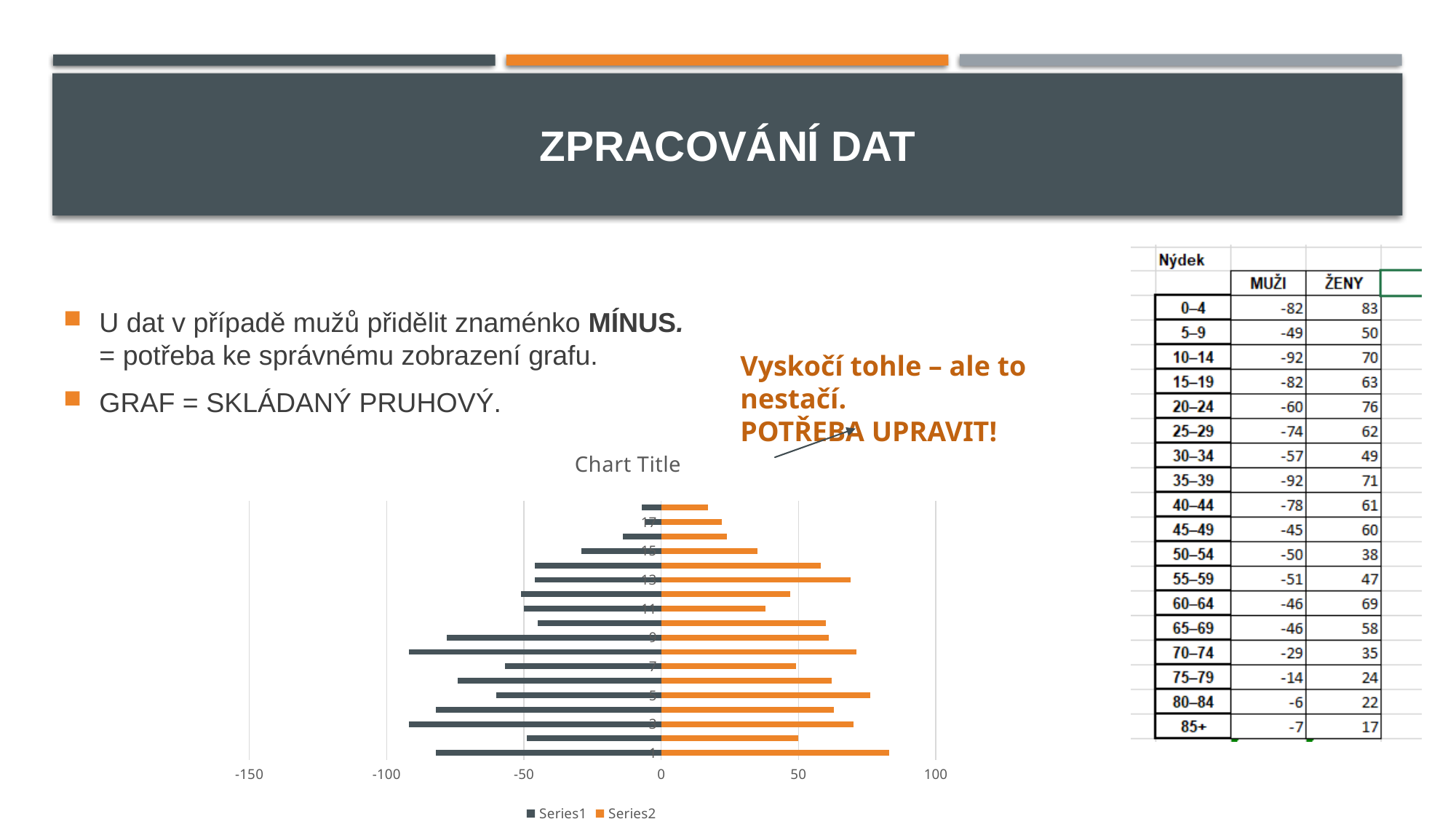
How many categories are plotted on the chart's vertical axis? 18 How many series does the chart legend list? 2 Is the Series2 bar for category 1 longer or shorter than the Series2 bar for category 17? longer Is the Series1 value for category 1 greater or less than -50? less Is the Series1 value for category 17 greater or less than -50? greater What is the title of the chart? Chart Title Is the Series2 value for category 13 greater or less than 50? greater What kind of chart is shown on the slide? bar chart What are the two series names shown in the chart legend? Series1 and Series2 Which series is plotted on the negative side of the horizontal axis? Series1